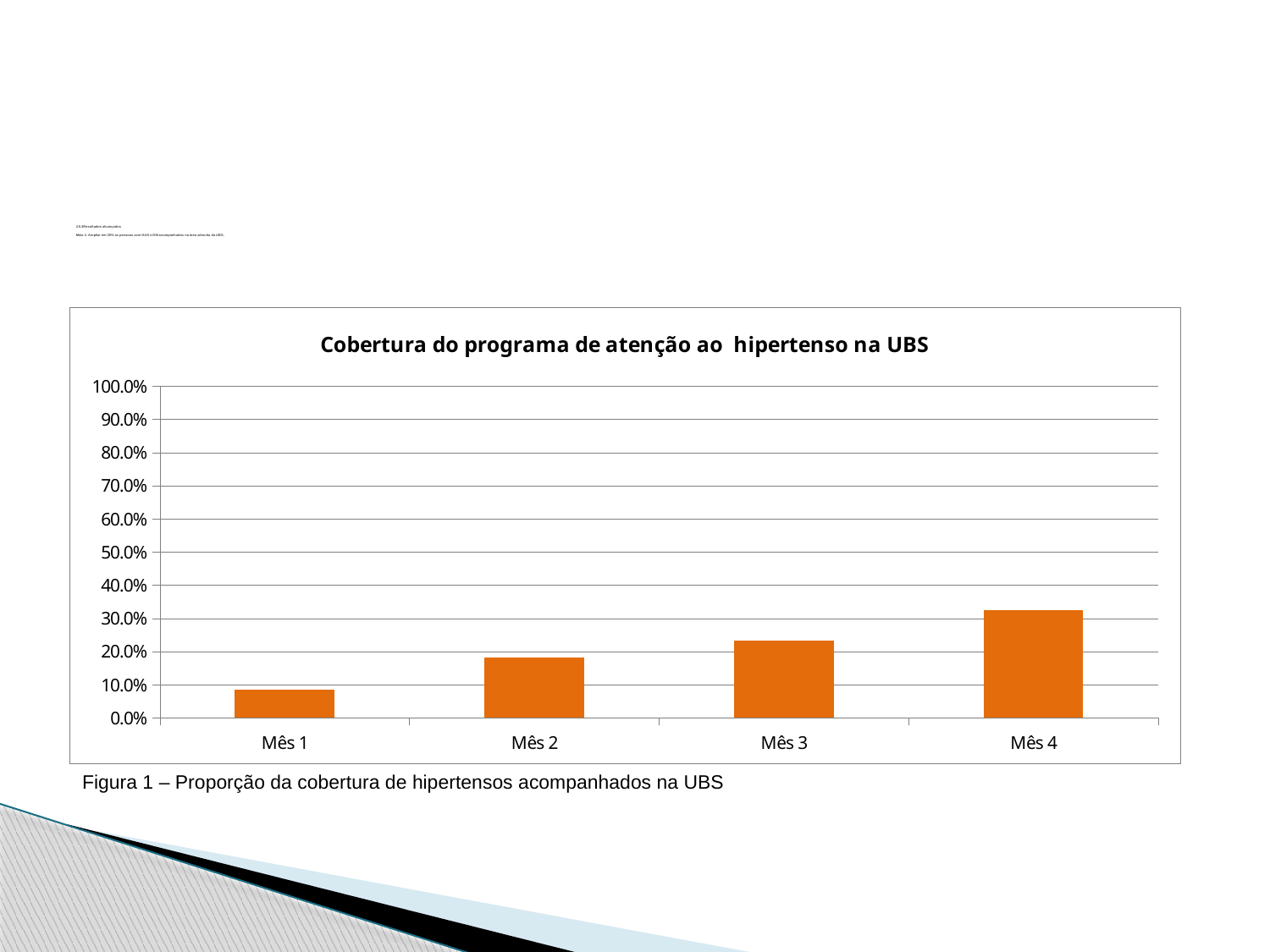
Which is larger, the value for Mês 2 or the value for Mês 3? Mês 3 Which month has the lowest value? Mês 1 How many categories (months) are plotted on the x axis? 4 Is the value for Mês 2 greater or less than 10.0%? greater What kind of chart is shown on the slide? bar chart Which month has the highest value? Mês 4 Is the value for Mês 3 greater or less than 30.0%? less Is the value for Mês 1 greater or less than 10.0%? less What is the title of the chart? Cobertura do programa de atenção ao hipertenso na UBS What is the maximum value shown on the y axis? 100.0% Do the values rise or fall from Mês 1 to Mês 4? rise